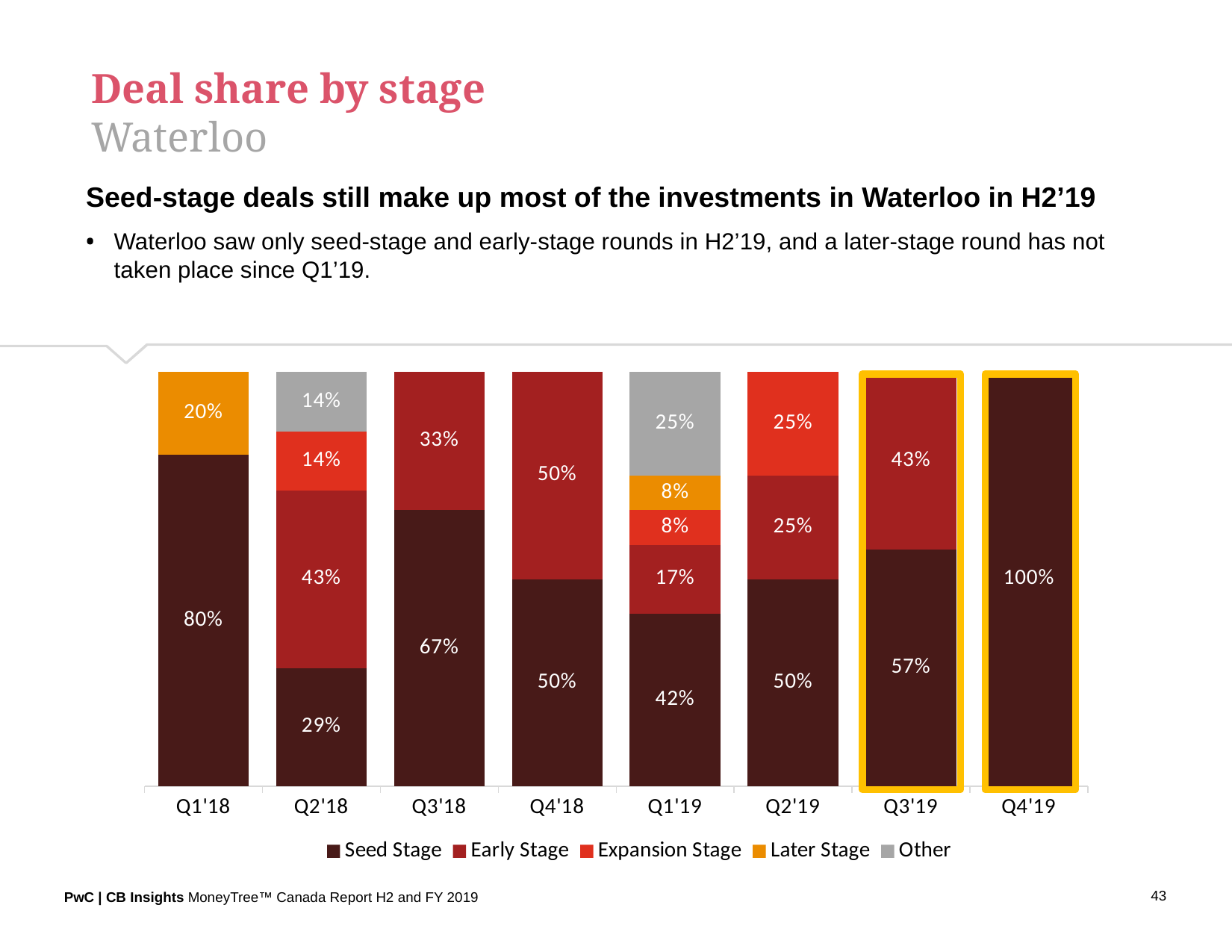
What is the Later Stage share in Q1'18? 20% What is the Seed Stage share in Q4'19? 100% How many series does the legend list? 5 Which quarter has the lowest Seed Stage share? Q2'18 Which quarter has the highest Seed Stage share? Q4'19 How many quarters are shown on the x axis? 8 What is the difference between the Seed Stage share in Q3'19 and the Early Stage share in Q3'19? 14% What is the Early Stage share in Q3'19? 43% Which is larger, the Seed Stage share in Q3'18 or the Seed Stage share in Q1'19? Q3'18 What is the Expansion Stage share in Q2'19? 25% What kind of chart is shown on the slide? Stacked bar chart What is the Other share in Q1'19? 25%